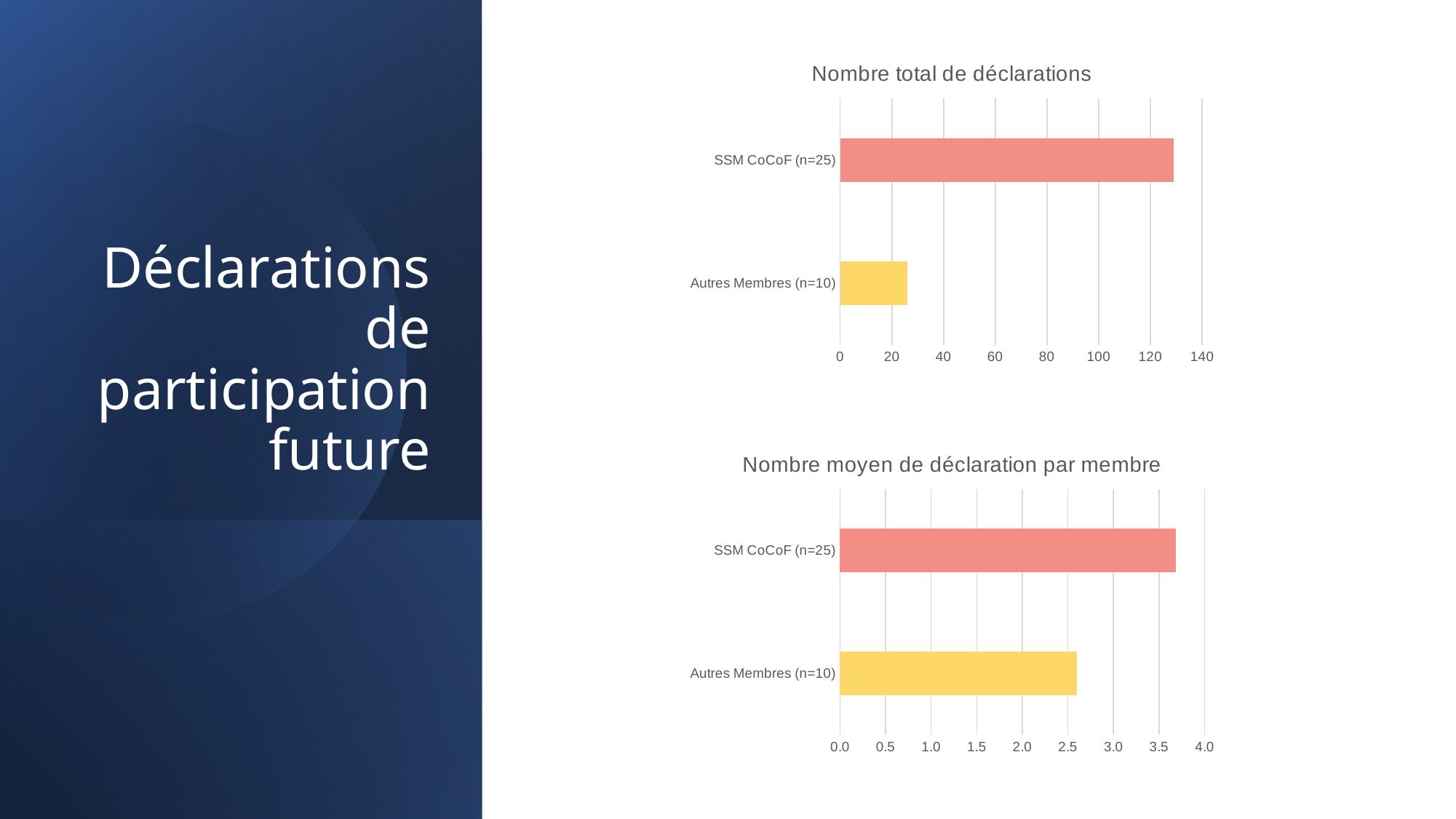
In the chart titled "Nombre moyen de déclaration par membre", is the value for Autres Membres (n=10) greater or less than 3.0? less In the chart titled "Nombre moyen de déclaration par membre", is the value for SSM CoCoF (n=25) greater or less than 3.5? greater What is the title of the bottom chart on the slide? Nombre moyen de déclaration par membre In the chart titled "Nombre total de déclarations", which category has the lowest value? Autres Membres (n=10) In the chart titled "Nombre total de déclarations", which category has the highest value? SSM CoCoF (n=25) In the chart titled "Nombre total de déclarations", is the value for Autres Membres (n=10) greater or less than 40? less In the chart titled "Nombre total de déclarations", how many categories are shown? 2 What kind of chart is the chart titled "Nombre total de déclarations"? bar chart In the chart titled "Nombre total de déclarations", what colour is the bar for Autres Membres (n=10)? yellow In the chart titled "Nombre moyen de déclaration par membre", which category has the highest value? SSM CoCoF (n=25) In the chart titled "Nombre moyen de déclaration par membre", which is larger: the value for SSM CoCoF (n=25) or the value for Autres Membres (n=10)? SSM CoCoF (n=25)